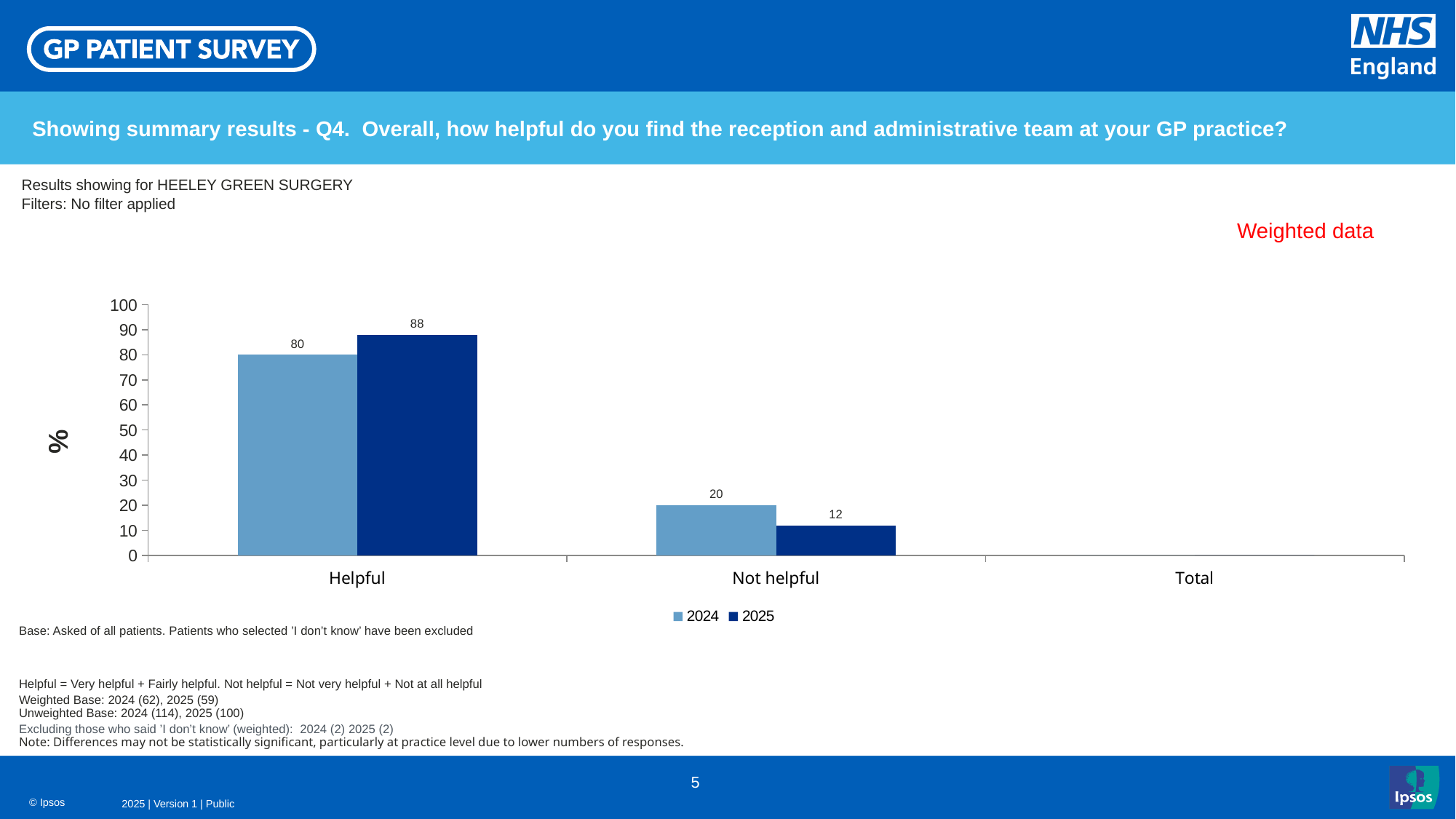
How many series does the legend list? 2 Which is larger, the 2024 value for Not helpful or the 2025 value for Not helpful? 2024 Which category has the lowest value in 2024? Not helpful Which category has the highest value in 2025? Helpful What kind of chart is shown on the slide? Bar chart What is the value for Not helpful in 2025? 12 What is the value for Helpful in 2025? 88 What is the value for Helpful in 2024? 80 What label is shown on the vertical axis of the chart? % What is the difference between the 2025 and 2024 values for Helpful? 8 What is the value for Not helpful in 2024? 20 What is the difference between the 2024 and 2025 values for Not helpful? 8